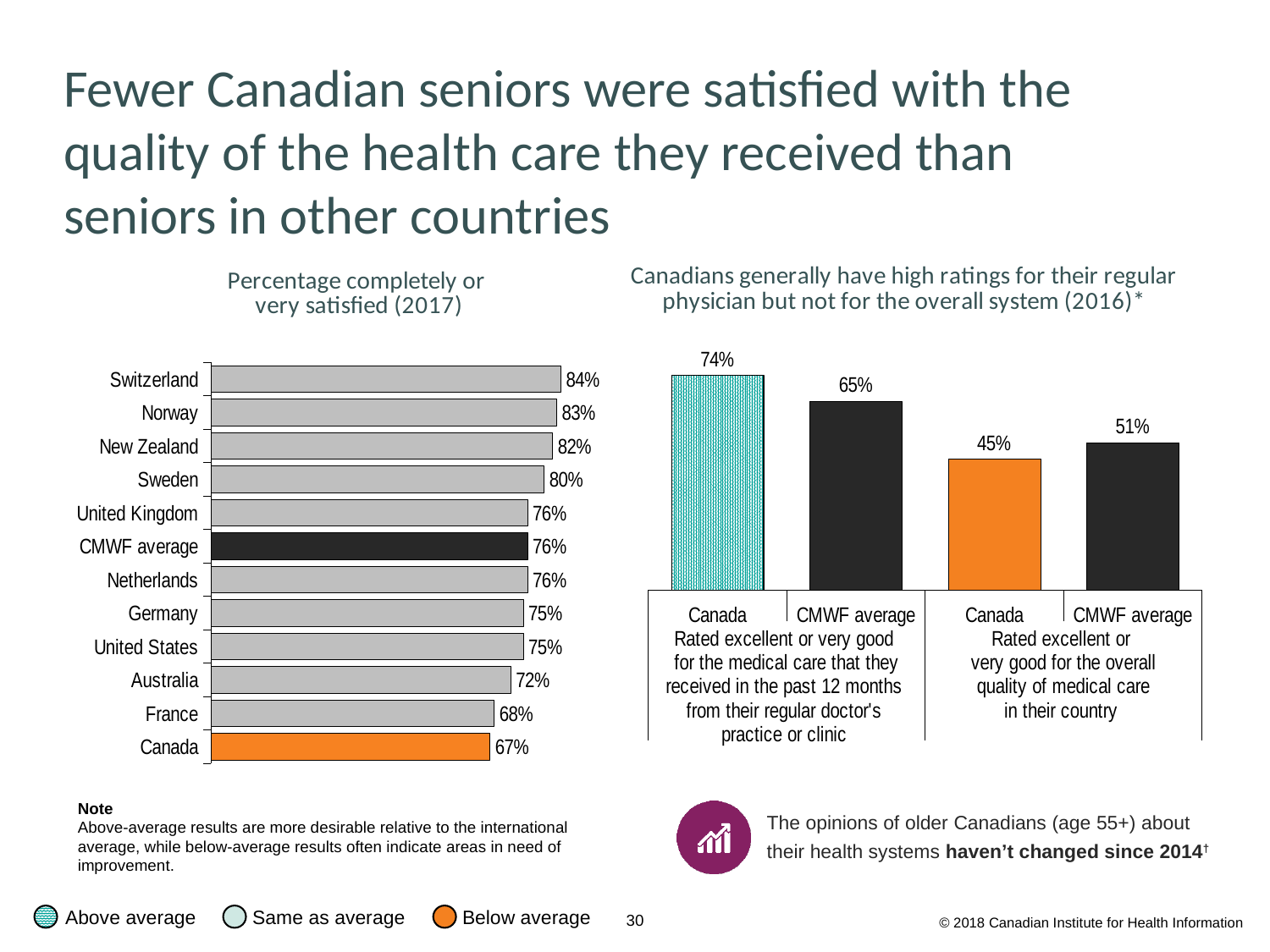
In the left chart 'Percentage completely or very satisfied (2017)', what is the value for Switzerland? 84% What kind of chart is the left chart 'Percentage completely or very satisfied (2017)'? Bar chart In the right chart, what is the CMWF average for rating the overall quality of medical care in their country as excellent or very good? 51% In the left chart 'Percentage completely or very satisfied (2017)', what is the difference between the CMWF average and Canada? 9% In the left chart 'Percentage completely or very satisfied (2017)', what is the value for Canada? 67% In the left chart 'Percentage completely or very satisfied (2017)', which is larger, the value for France or the value for Australia? Australia In the left chart 'Percentage completely or very satisfied (2017)', which country has the highest value? Switzerland In the left chart 'Percentage completely or very satisfied (2017)', what colour is the bar for Canada? Orange In the left chart 'Percentage completely or very satisfied (2017)', which country has the lowest value? Canada In the right chart, what is the difference between Canada and the CMWF average for rating the overall quality of medical care in their country? 6% In the right chart, what percentage of Canadians rated the medical care they received in the past 12 months from their regular doctor's practice or clinic as excellent or very good? 74% In the left chart 'Percentage completely or very satisfied (2017)', how many bars are shown? 12